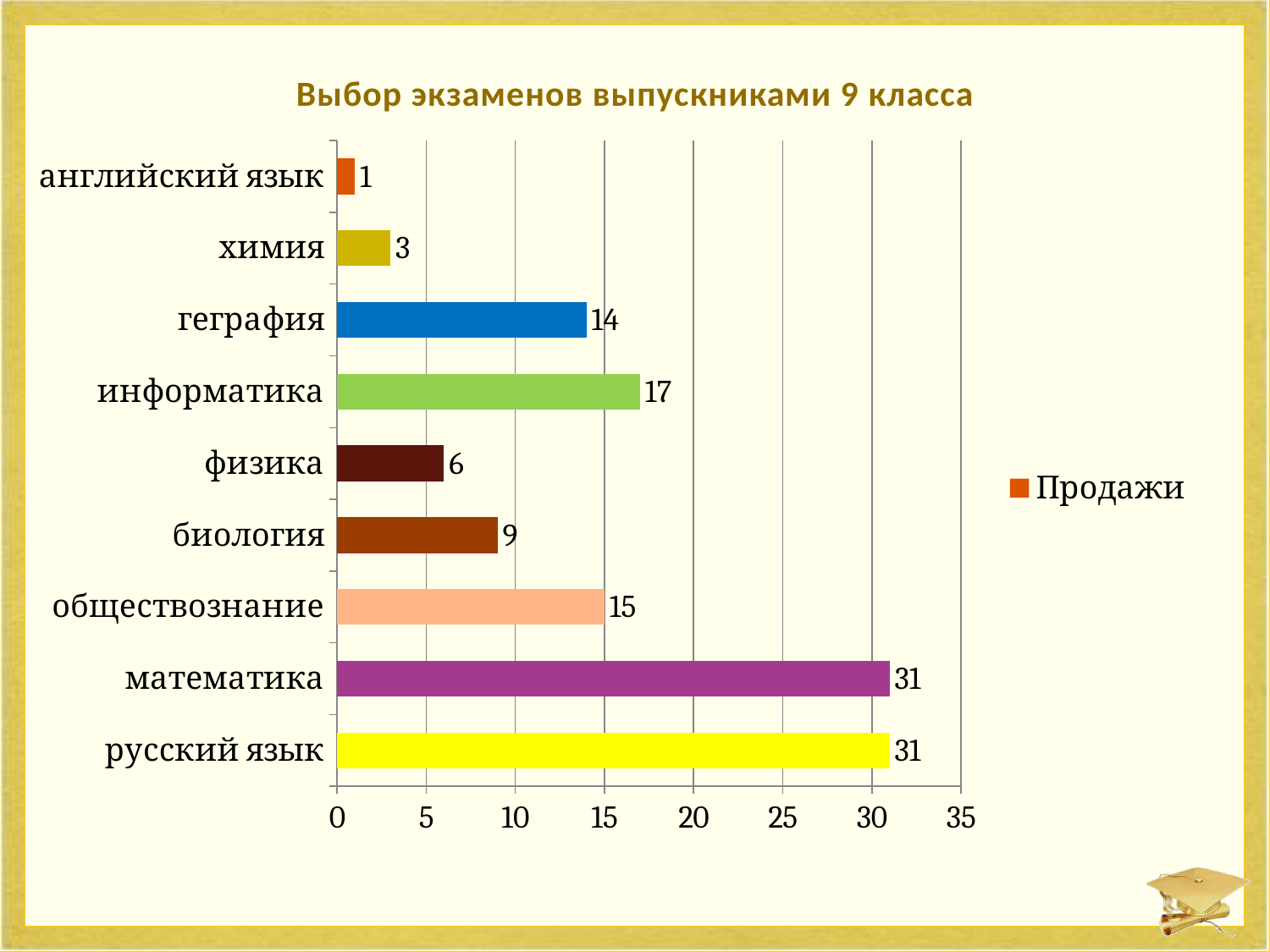
Which is larger, the value for геграфия or the value for биология? геграфия Which category has the lowest value? английский язык How many series does the legend list? 1 How many categories are shown on the chart? 9 What is the title of the chart? Выбор экзаменов выпускниками 9 класса What kind of chart is shown on the slide? bar chart What is the name of the series in the legend? Продажи What is the value for физика? 6 What is the difference between the values for математика and информатика? 14 What is the difference between the values for химия and английский язык? 2 What is the value for информатика? 17 What is the value for обществознание? 15